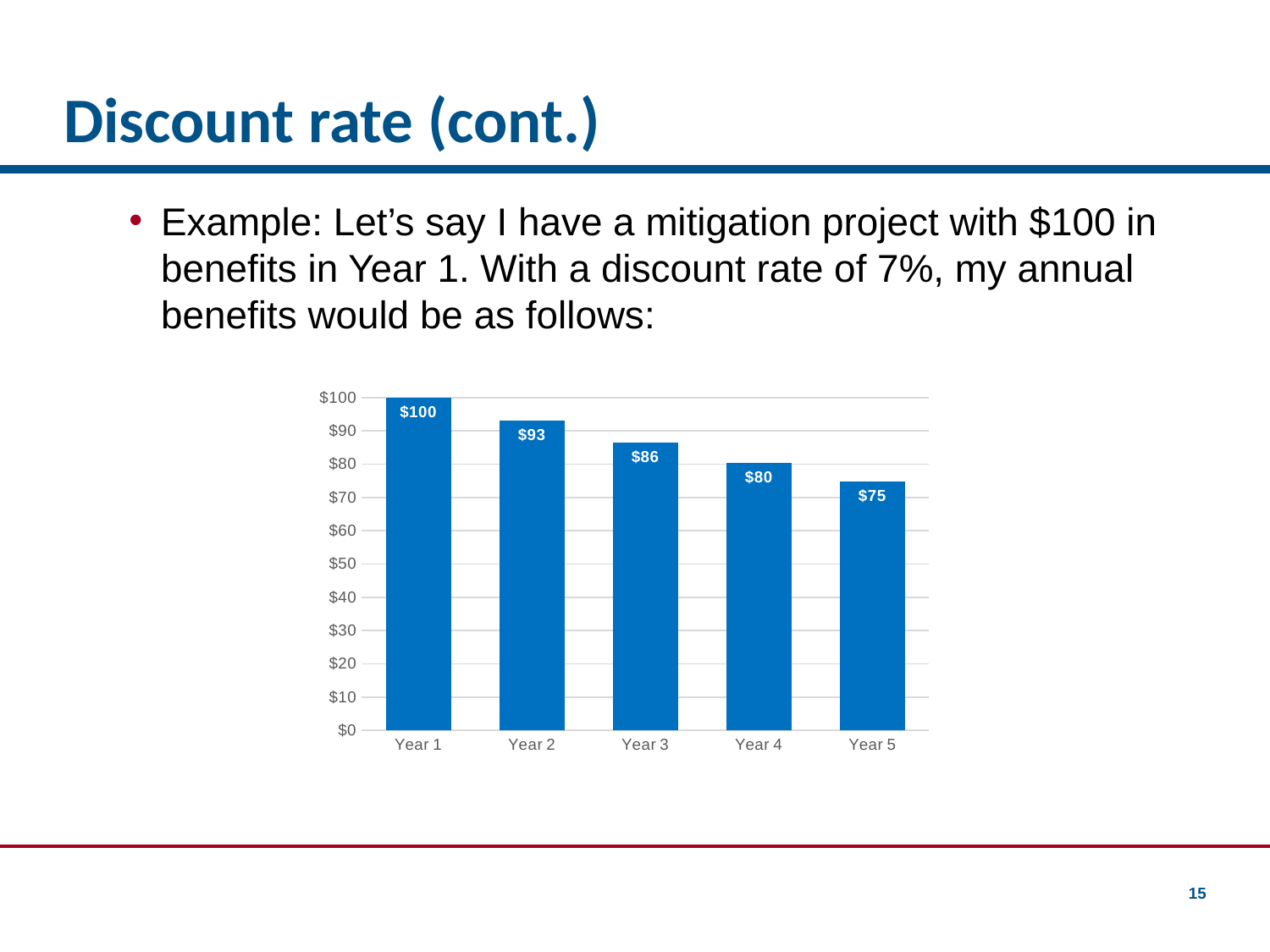
Which year has the highest value? Year 1 Which year has the lowest value? Year 5 Which is larger, the value for Year 2 or the value for Year 4? Year 2 What is the value for Year 3? $86 What is the difference between the values for Year 1 and Year 2? $7 What kind of chart is shown on the slide? bar chart Do the values rise or fall from Year 1 to Year 5? fall What is the value for Year 1? $100 What is the difference between the values for Year 3 and Year 5? $11 How many years are shown on the x axis? 5 What is the value for Year 5? $75 Is the value for Year 4 greater or less than $90? less